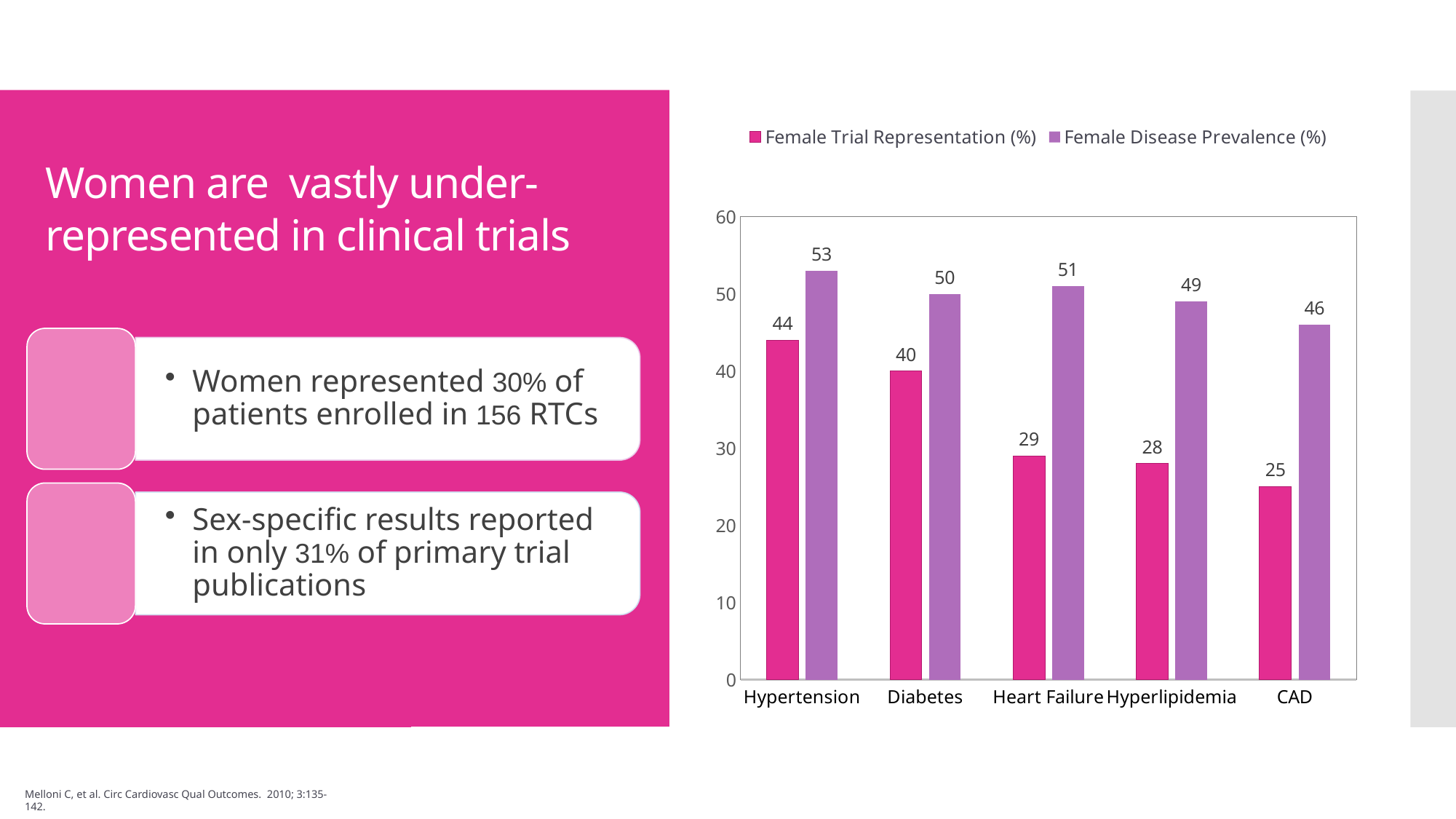
What is the difference between Female Disease Prevalence (%) and Female Trial Representation (%) for Hyperlipidemia? 21 Which category has the lowest Female Trial Representation (%)? CAD How many categories are shown on the x axis of the chart? 5 What is the difference between Female Trial Representation (%) for Diabetes and for CAD? 15 Which is larger for Diabetes: Female Trial Representation (%) or Female Disease Prevalence (%)? Female Disease Prevalence (%) How many series does the chart legend list? 2 Does the Female Trial Representation (%) series rise or fall from Hypertension to CAD along the x axis? Fall What is the Female Disease Prevalence (%) value for CAD? 46 What is the Female Trial Representation (%) value for Hypertension? 44 Which category has the highest Female Disease Prevalence (%)? Hypertension What is the Female Trial Representation (%) value for Heart Failure? 29 What kind of chart is shown on the slide? Bar chart